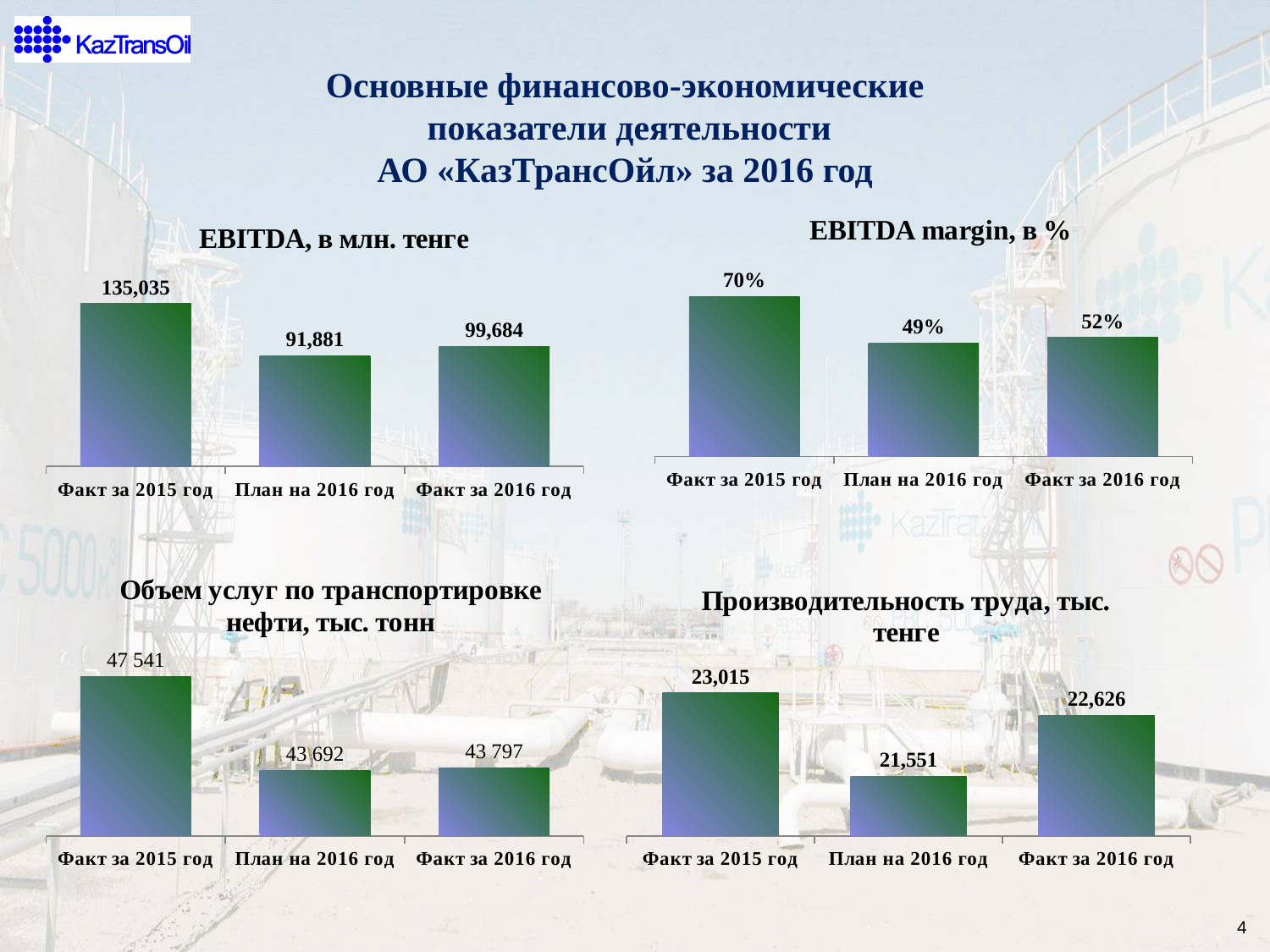
In the chart titled "Производительность труда, тыс. тенге", which is larger: Факт за 2015 год or Факт за 2016 год? Факт за 2015 год In the chart titled "EBITDA margin, в %", what is the value for План на 2016 год? 49% In the chart titled "EBITDA, в млн. тенге", what is the value for Факт за 2015 год? 135,035 In the chart titled "EBITDA margin, в %", which category has the highest value? Факт за 2015 год In the chart titled "EBITDA margin, в %", how much higher is Факт за 2015 год than Факт за 2016 год? 18% In the chart titled "Объем услуг по транспортировке нефти, тыс. тонн", what is the difference between Факт за 2015 год and Факт за 2016 год? 3 744 In the chart titled "EBITDA, в млн. тенге", what is the difference between Факт за 2016 год and План на 2016 год? 7,803 How many categories are shown in the chart titled "Производительность труда, тыс. тенге"? 3 In the chart titled "EBITDA, в млн. тенге", which category has the lowest value? План на 2016 год What type of chart is the chart titled "EBITDA, в млн. тенге"? Bar chart In the chart titled "Производительность труда, тыс. тенге", what is the value for План на 2016 год? 21,551 In the chart titled "Объем услуг по транспортировке нефти, тыс. тонн", what is the value for Факт за 2016 год? 43 797